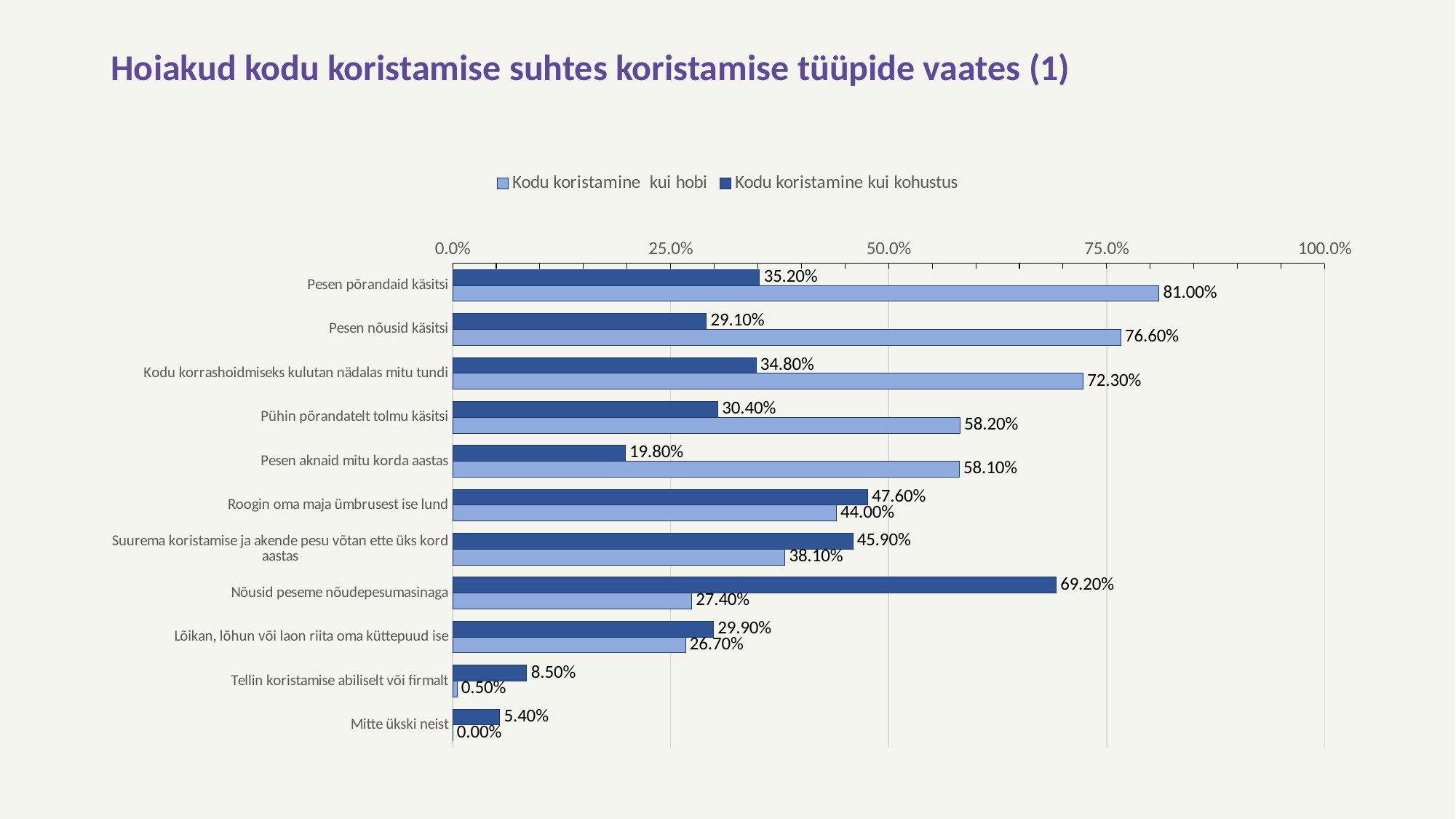
What kind of chart is shown on the slide? Bar chart What is the value for "Pesen aknaid mitu korda aastas" in the "Kodu koristamine kui kohustus" series? 19.80% How many series does the legend list? 2 What is the value for "Pesen põrandaid käsitsi" in the "Kodu koristamine kui hobi" series? 81.00% Is the "Kodu koristamine kui hobi" value for "Kodu korrashoidmiseks kulutan nädalas mitu tundi" greater or less than 50.0%? greater For "Roogin oma maja ümbrusest ise lund", which series has the larger value? Kodu koristamine kui kohustus What is the value for "Nõusid peseme nõudepesumasinaga" in the "Kodu koristamine kui kohustus" series? 69.20% What is the title of the slide? Hoiakud kodu koristamise suhtes koristamise tüüpide vaates (1) What is the difference between the "Kodu koristamine kui hobi" and "Kodu koristamine kui kohustus" values for "Pesen nõusid käsitsi"? 47.50% Which category has the lowest value in the "Kodu koristamine kui kohustus" series? Mitte ükski neist Which category has the highest value in the "Kodu koristamine kui hobi" series? Pesen põrandaid käsitsi How many categories are shown on the chart? 11